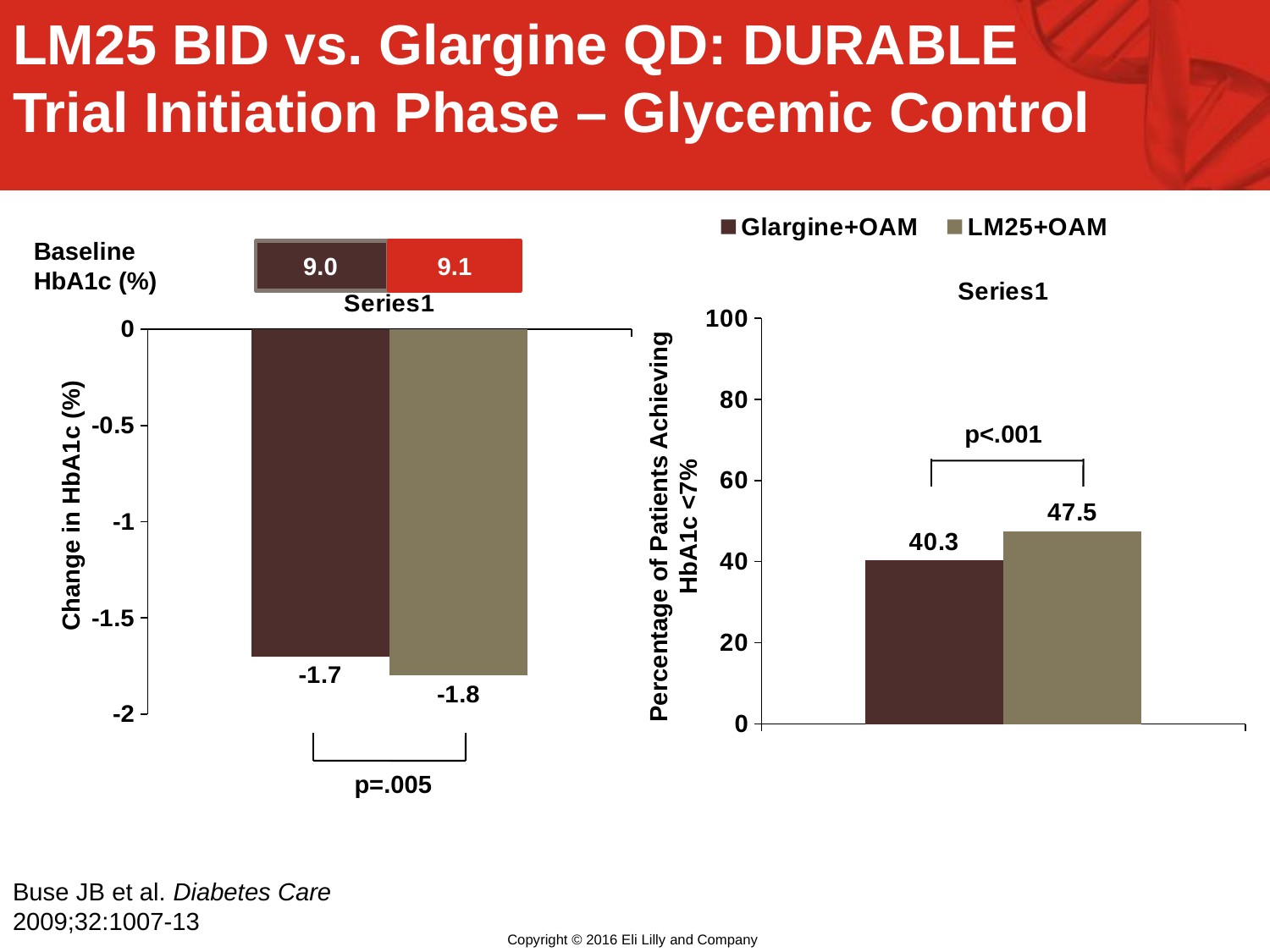
In the left chart, is the value for Glargine+OAM greater or less than -1.5? less How many series does the legend list? 2 In the right chart, is the value for LM25+OAM greater or less than 40? greater In the left chart (Change in HbA1c), what is the value for LM25+OAM? -1.8 In the left chart (Change in HbA1c), what is the value for Glargine+OAM? -1.7 In the right chart, what is the difference between the LM25+OAM and Glargine+OAM values? 7.2 In the right chart (Percentage of Patients Achieving HbA1c <7%), what is the value for LM25+OAM? 47.5 What p-value is shown on the right chart? p<.001 In the right chart, which treatment group has the higher percentage of patients achieving HbA1c <7%? LM25+OAM What kind of chart is the right chart? Bar chart In the right chart (Percentage of Patients Achieving HbA1c <7%), what is the value for Glargine+OAM? 40.3 In the left chart, what is the difference between the Glargine+OAM and LM25+OAM values? 0.1